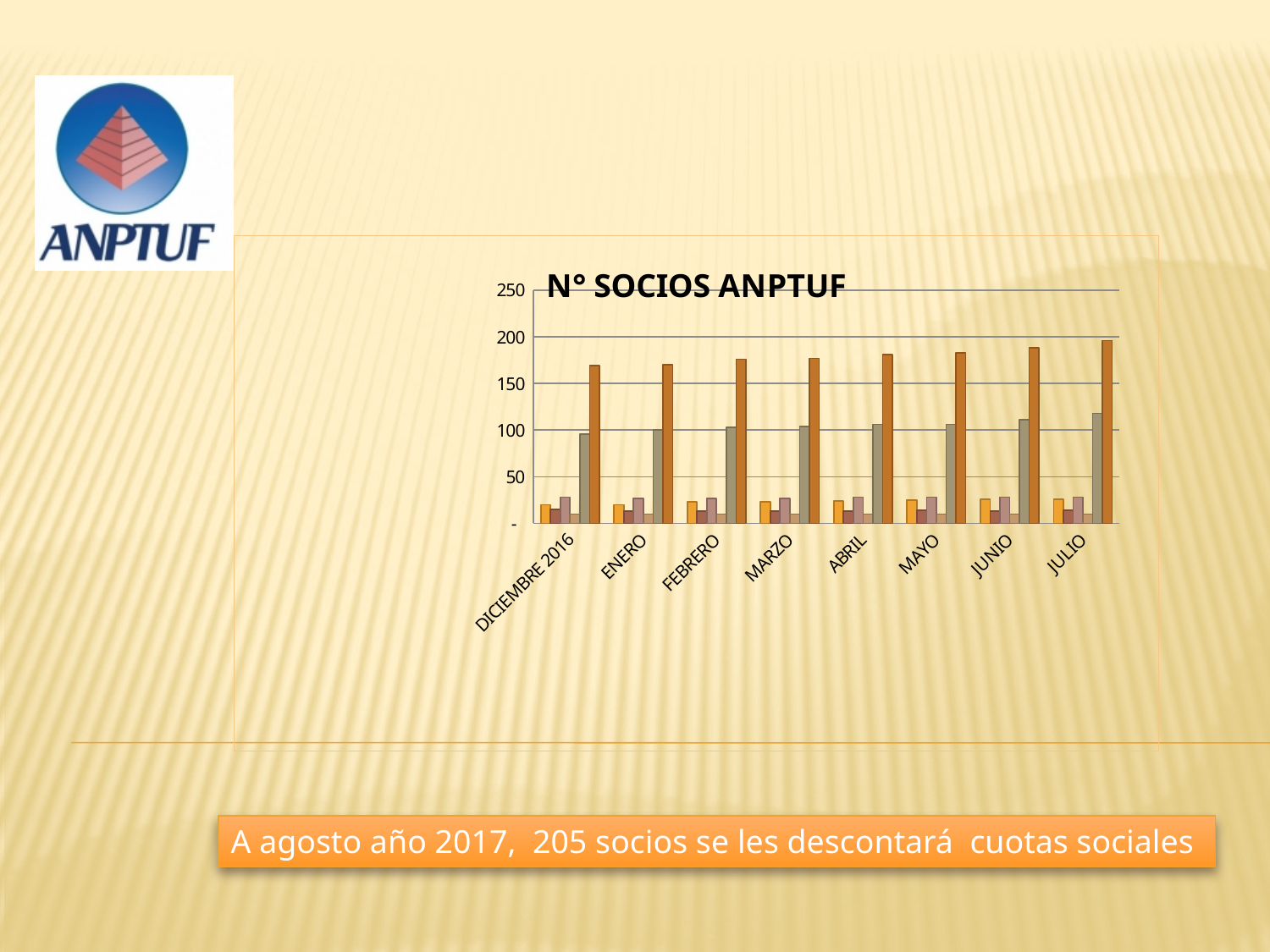
Is the value of the tallest bar for MARZO greater or less than 200? less Is the value of the tallest bar for DICIEMBRE 2016 greater or less than 150? greater Which category is the first one on the x axis of the chart? DICIEMBRE 2016 How many categories (months) are shown on the x axis of the chart? 8 Is the value of the first (orange) bar for ENERO greater or less than 50? less Which month has the highest tallest bar in the chart? JULIO What is the title of the chart? N° SOCIOS ANPTUF Which has the larger tallest bar, JULIO or DICIEMBRE 2016? JULIO What kind of chart is shown on the slide? bar chart Do the values of the tallest bars rise or fall from DICIEMBRE 2016 to JULIO? rise